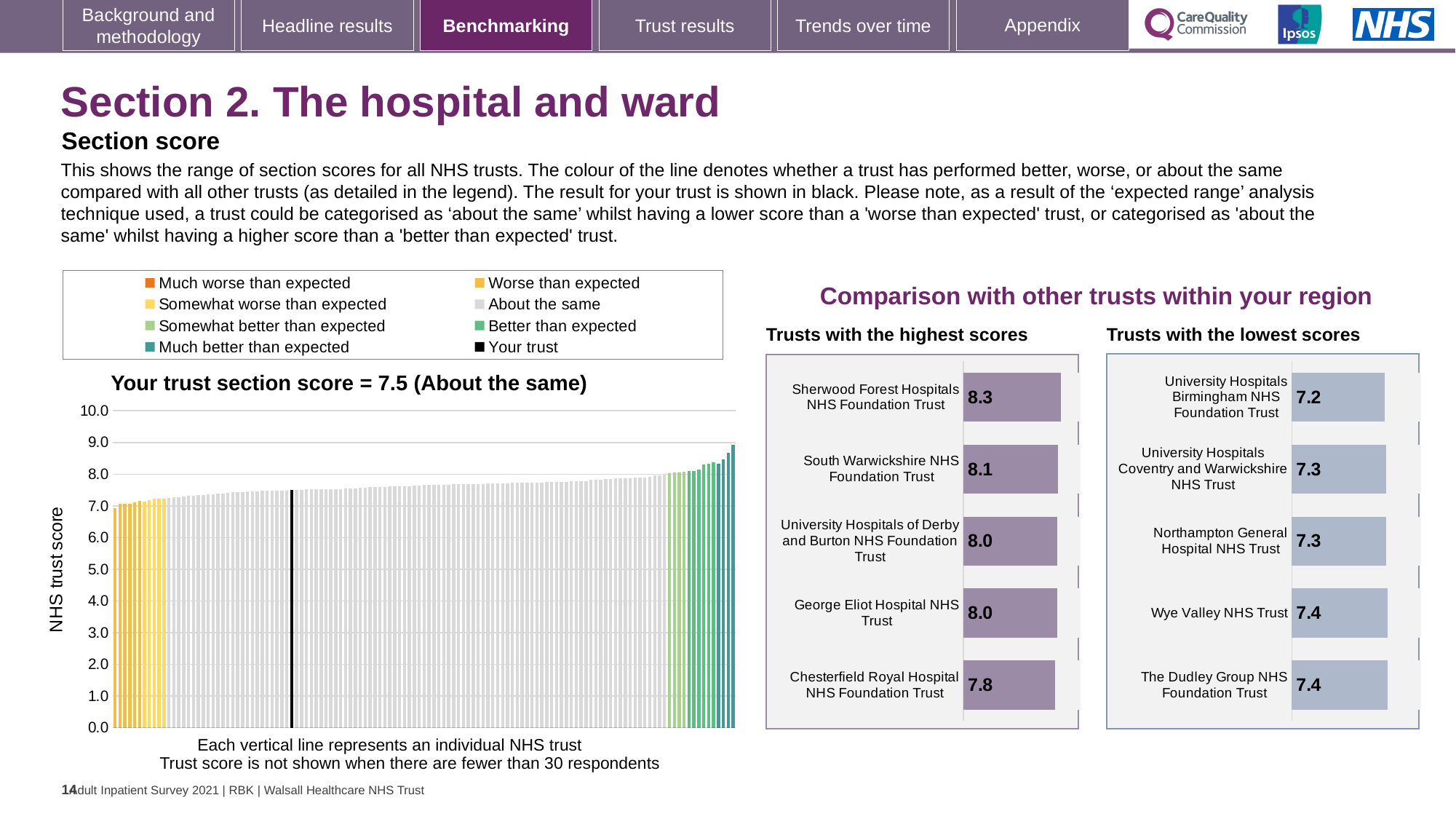
On the 'Trusts with the lowest scores' chart, which trust has the lowest score? University Hospitals Birmingham NHS Foundation Trust On the 'Your trust section score' chart, do the bar heights rise or fall from left to right? rise What kind of chart is the 'Your trust section score' chart? bar chart On the 'Trusts with the highest scores' chart, what is the score for Sherwood Forest Hospitals NHS Foundation Trust? 8.3 On the 'Trusts with the lowest scores' chart, which has the higher score: Wye Valley NHS Trust or University Hospitals Birmingham NHS Foundation Trust? Wye Valley NHS Trust On the 'Your trust section score' chart, what is the section score for your trust? 7.5 How many trusts are shown on the 'Trusts with the highest scores' chart? 5 On the 'Trusts with the highest scores' chart, which trust has the lowest score? Chesterfield Royal Hospital NHS Foundation Trust What is the y-axis label on the 'Your trust section score' chart? NHS trust score How many entries does the legend above the 'Your trust section score' chart list? 8 On the 'Trusts with the lowest scores' chart, what is the score for Northampton General Hospital NHS Trust? 7.3 On the 'Trusts with the highest scores' chart, what is the difference between the scores of Sherwood Forest Hospitals NHS Foundation Trust and Chesterfield Royal Hospital NHS Foundation Trust? 0.5